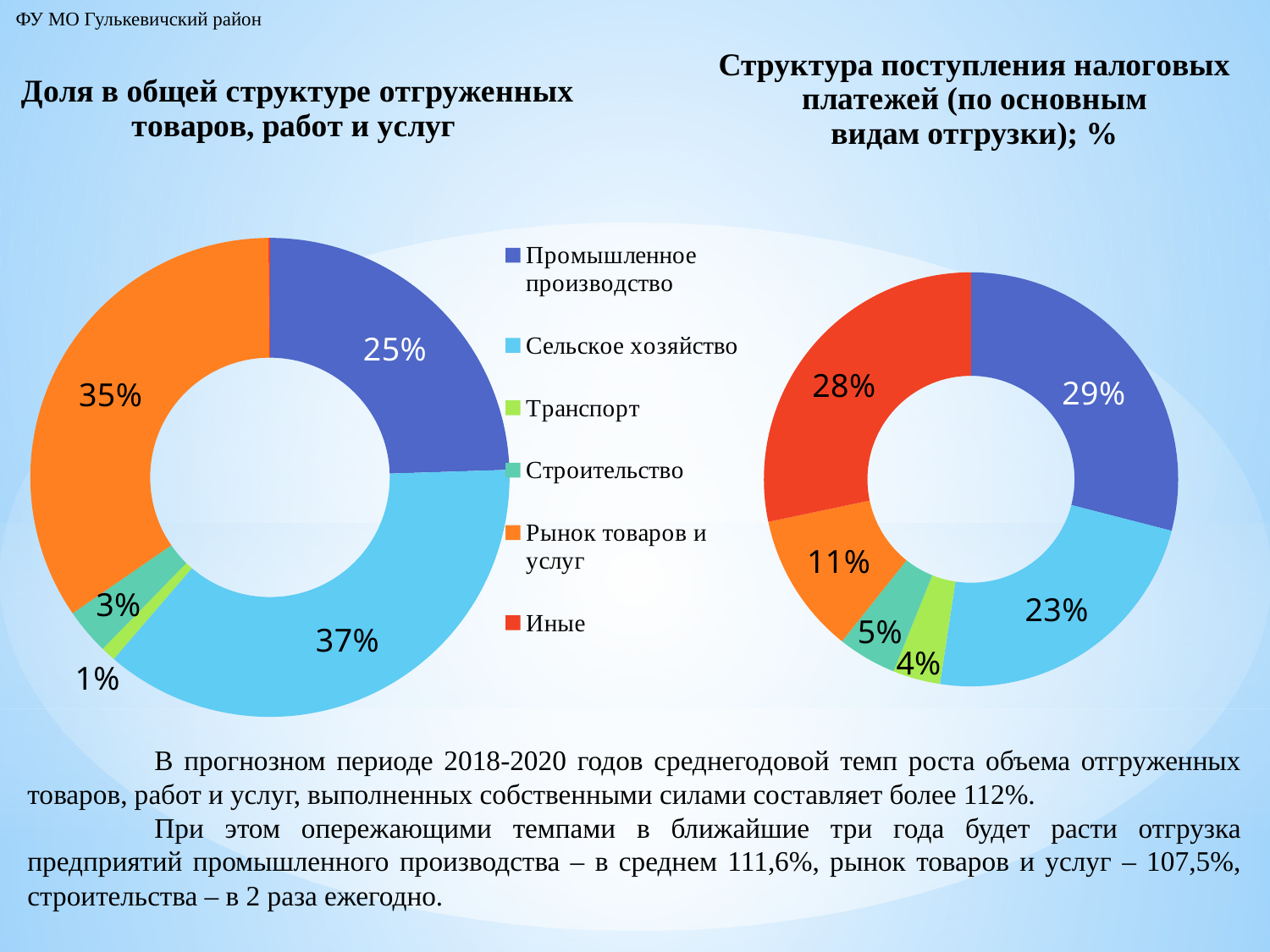
In the left chart 'Доля в общей структуре отгруженных товаров, работ и услуг', what is the share for Рынок товаров и услуг? 35% In the right chart 'Структура поступления налоговых платежей', what is the difference between the shares of Сельское хозяйство and Рынок товаров и услуг? 12% In the right chart 'Структура поступления налоговых платежей', which category has the smallest share? Транспорт In the left chart 'Доля в общей структуре отгруженных товаров, работ и услуг', which category has the largest share? Сельское хозяйство In the left chart 'Доля в общей структуре отгруженных товаров, работ и услуг', what is the difference between the shares of Сельское хозяйство and Промышленное производство? 12% In the right chart 'Структура поступления налоговых платежей', which is larger: Сельское хозяйство or Рынок товаров и услуг? Сельское хозяйство What type of chart is used on this slide? Doughnut (pie) chart How many entries does the legend list? 6 In the right chart 'Структура поступления налоговых платежей', what is the share for Иные? 28% In the left chart 'Доля в общей структуре отгруженных товаров, работ и услуг', what is the share for Сельское хозяйство? 37% In the right chart 'Структура поступления налоговых платежей', what is the share for Промышленное производство? 29%